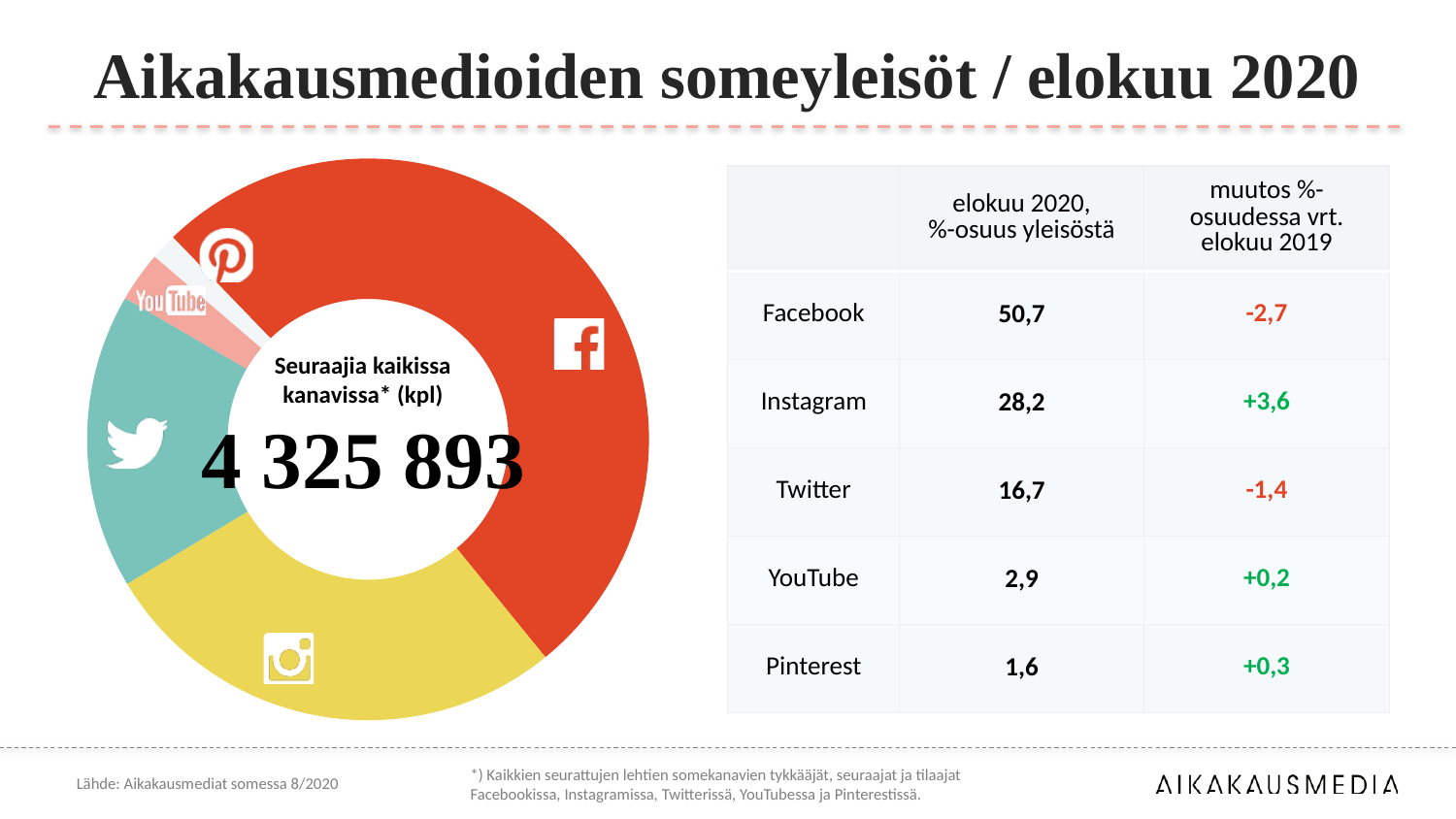
What is the difference in percentage share between Facebook and Instagram in August 2020? 22,5 What kind of chart is shown on the left of the slide? Donut (pie) chart What total number of followers across all channels is printed in the centre of the donut chart? 4 325 893 Which slice is larger in the donut chart, Instagram or Twitter? Instagram Which social media channel has the largest slice in the donut chart? Facebook How many slices does the donut chart have? 5 What is the change in Instagram's percentage share compared with August 2019? +3,6 Which social media channel has the smallest slice in the donut chart? Pinterest According to the table, what is Twitter's share of the audience in August 2020? 16,7 What is the change in Facebook's percentage share compared with August 2019? -2,7 According to the table, what is Instagram's share of the audience in August 2020? 28,2 According to the table, what is Facebook's share of the audience in August 2020? 50,7